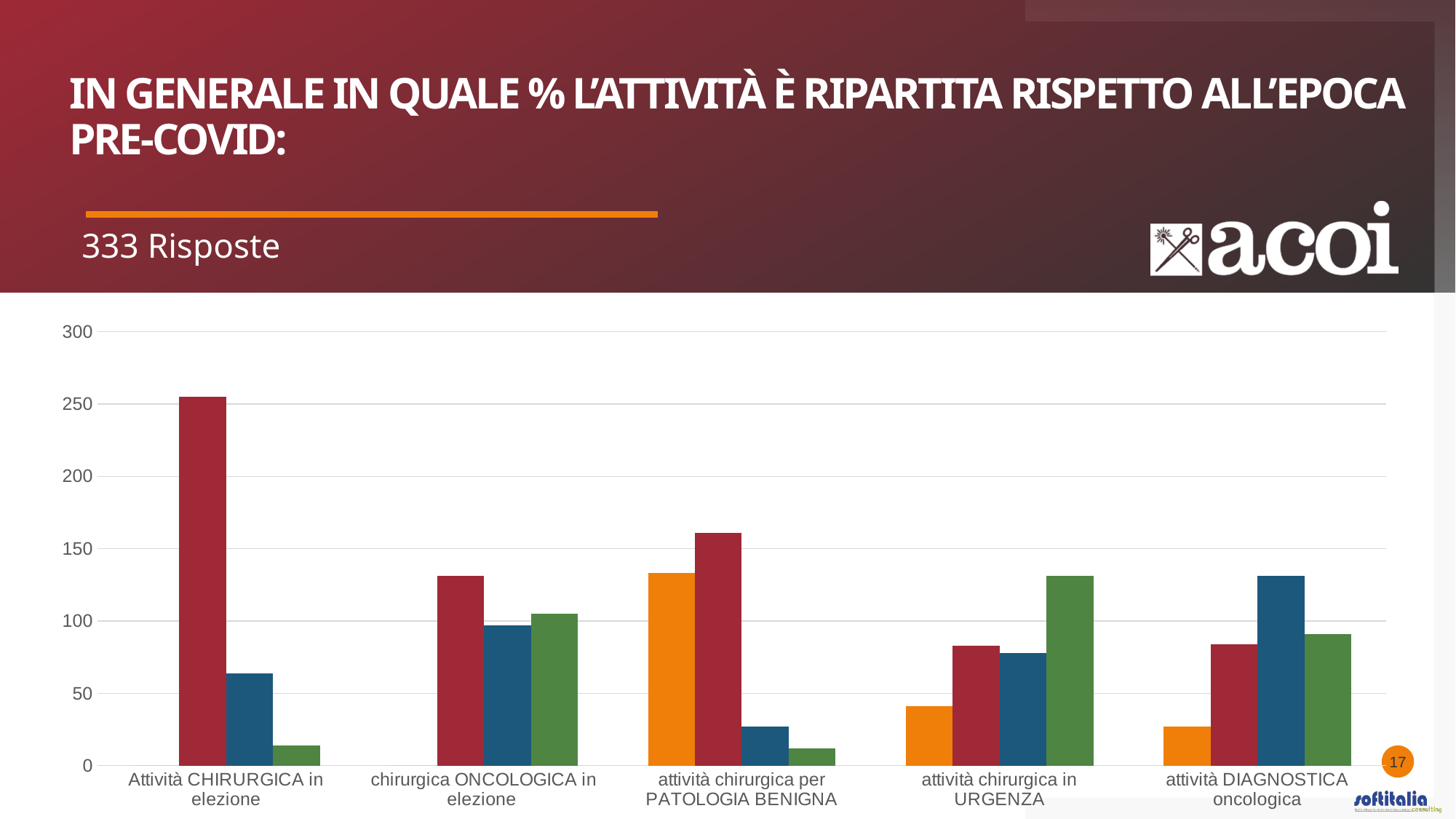
For attività DIAGNOSTICA oncologica, which bar is larger, the blue bar or the orange bar? blue For attività chirurgica in URGENZA, which bar is larger, the green bar or the orange bar? green How many responses (Risposte) does the slide say the chart is based on? 333 Is the value of the blue bar for attività chirurgica per PATOLOGIA BENIGNA greater or less than 50? less Is the value of the red bar for Attività CHIRURGICA in elezione greater or less than 200? greater For attività chirurgica per PATOLOGIA BENIGNA, which bar is larger, the red bar or the orange bar? red Which category contains the tallest bar in the chart? Attività CHIRURGICA in elezione How many categories are shown along the x axis of the chart? 5 Is the value of the orange bar for attività chirurgica per PATOLOGIA BENIGNA greater or less than 100? greater What kind of chart is shown on the slide? bar chart Within the category Attività CHIRURGICA in elezione, which coloured bar is the lowest? green